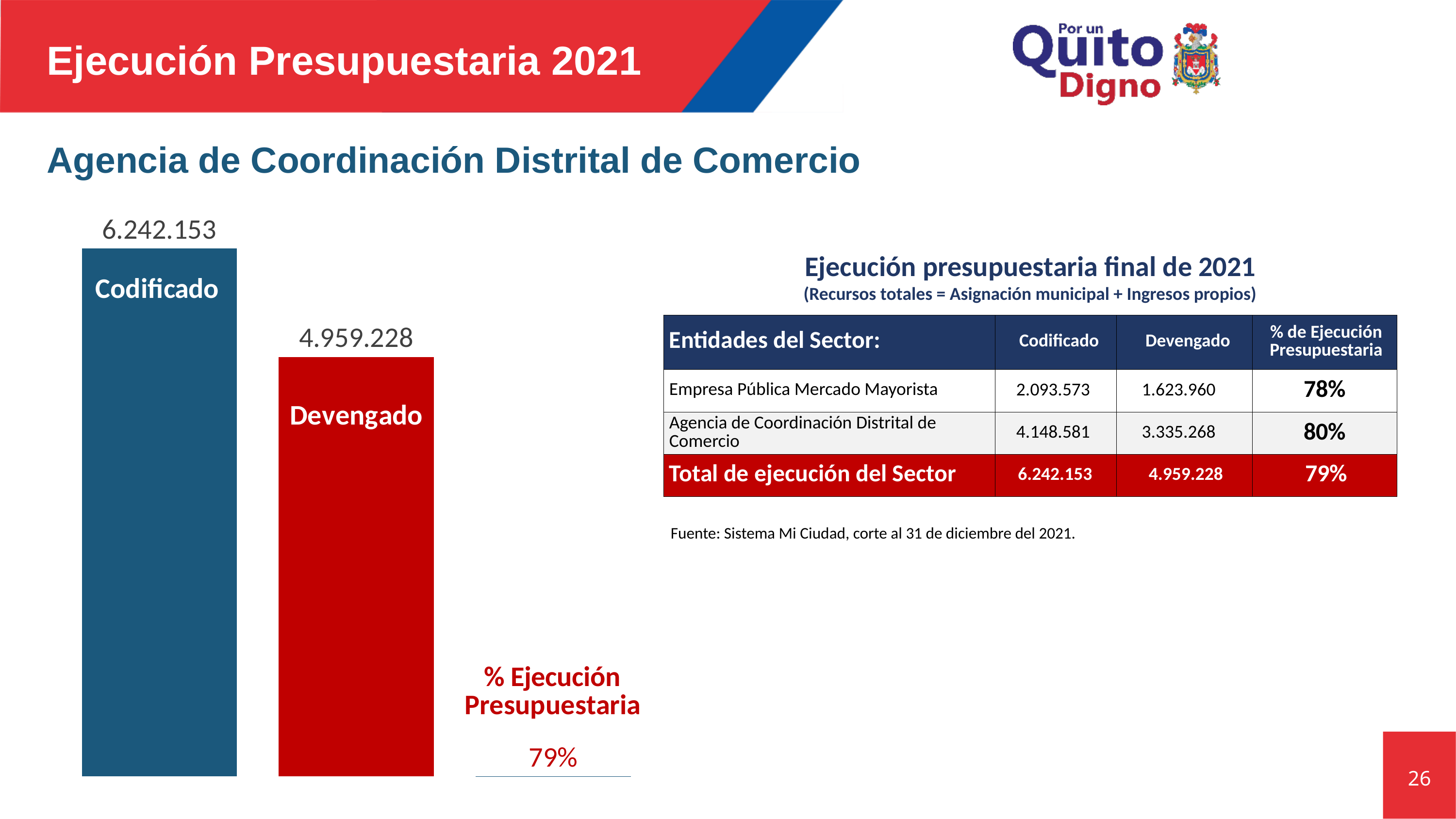
What is the value of the Devengado bar in the bar chart? 4.959.228 What is the difference between the Codificado and Devengado bars in the chart? 1.282.925 What is the value of the Codificado bar in the bar chart? 6.242.153 Which bar in the chart is the lowest? Devengado Which bar in the chart is the highest? Codificado What percentage is shown as the % Ejecución Presupuestaria next to the bar chart? 79% What colour is the Codificado bar in the chart? Blue What colour is the Devengado bar in the chart? Red Which is larger in the bar chart, Codificado or Devengado? Codificado How many bars are shown in the bar chart? 2 What kind of chart is shown on the left of the slide? Bar chart